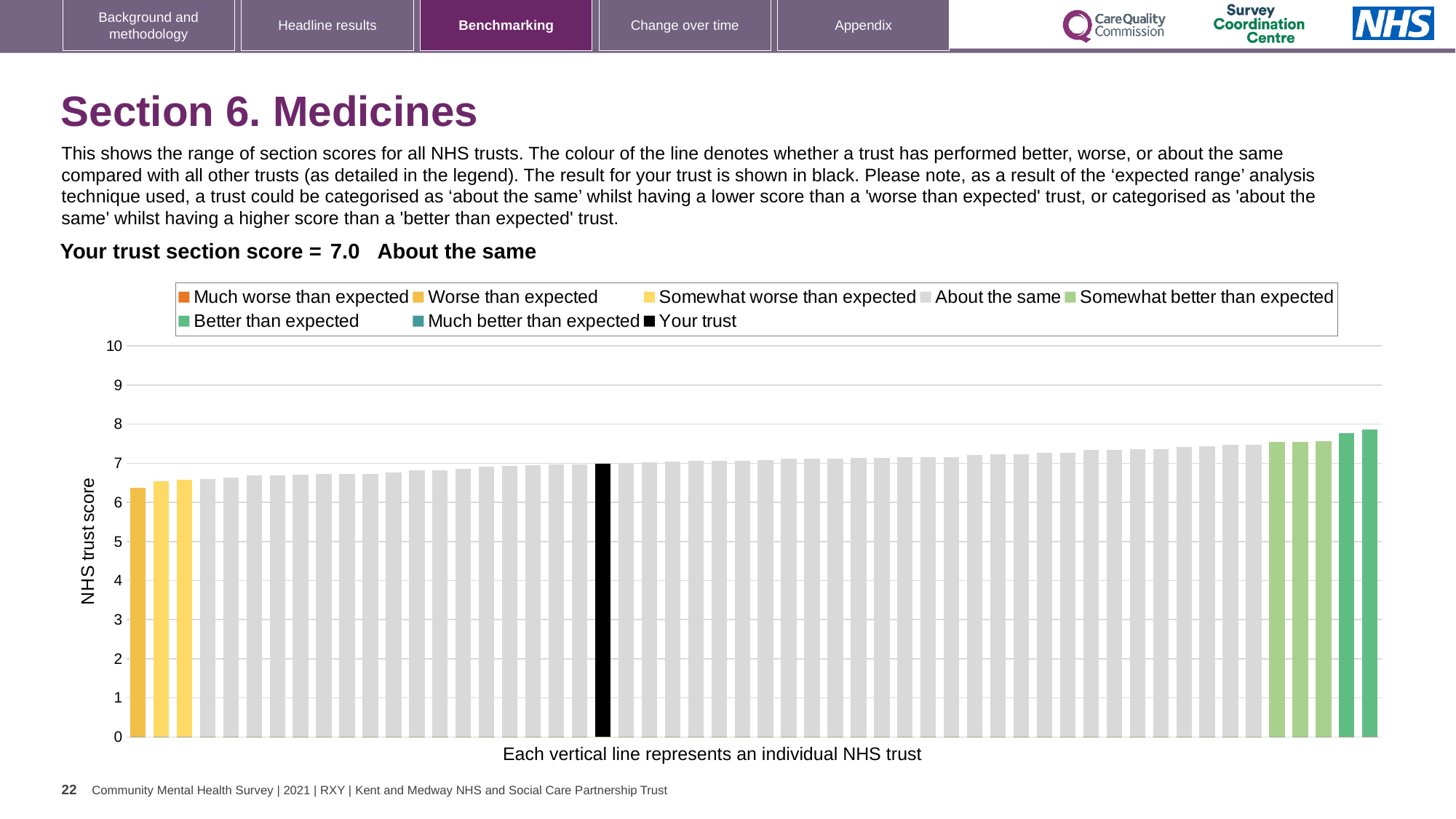
Do the bar values rise or fall from left to right across the chart? rise How many entries does the chart legend list? 8 Is the value for your trust (the black bar) greater or less than 5? greater What kind of chart is shown on the slide? bar chart Is the value of the lowest bar in the chart greater or less than 6? greater Which is larger: the value of the leftmost bar or the value of the rightmost bar? the rightmost bar How many bars in the chart are shaded in yellow tones (worse than expected categories)? 3 What is the section score for your trust shown on the slide? 7.0 Is the value of the highest bar in the chart greater or less than 7? greater Which benchmarking category is your trust placed in for this section? About the same What is the label on the vertical axis of the chart? NHS trust score